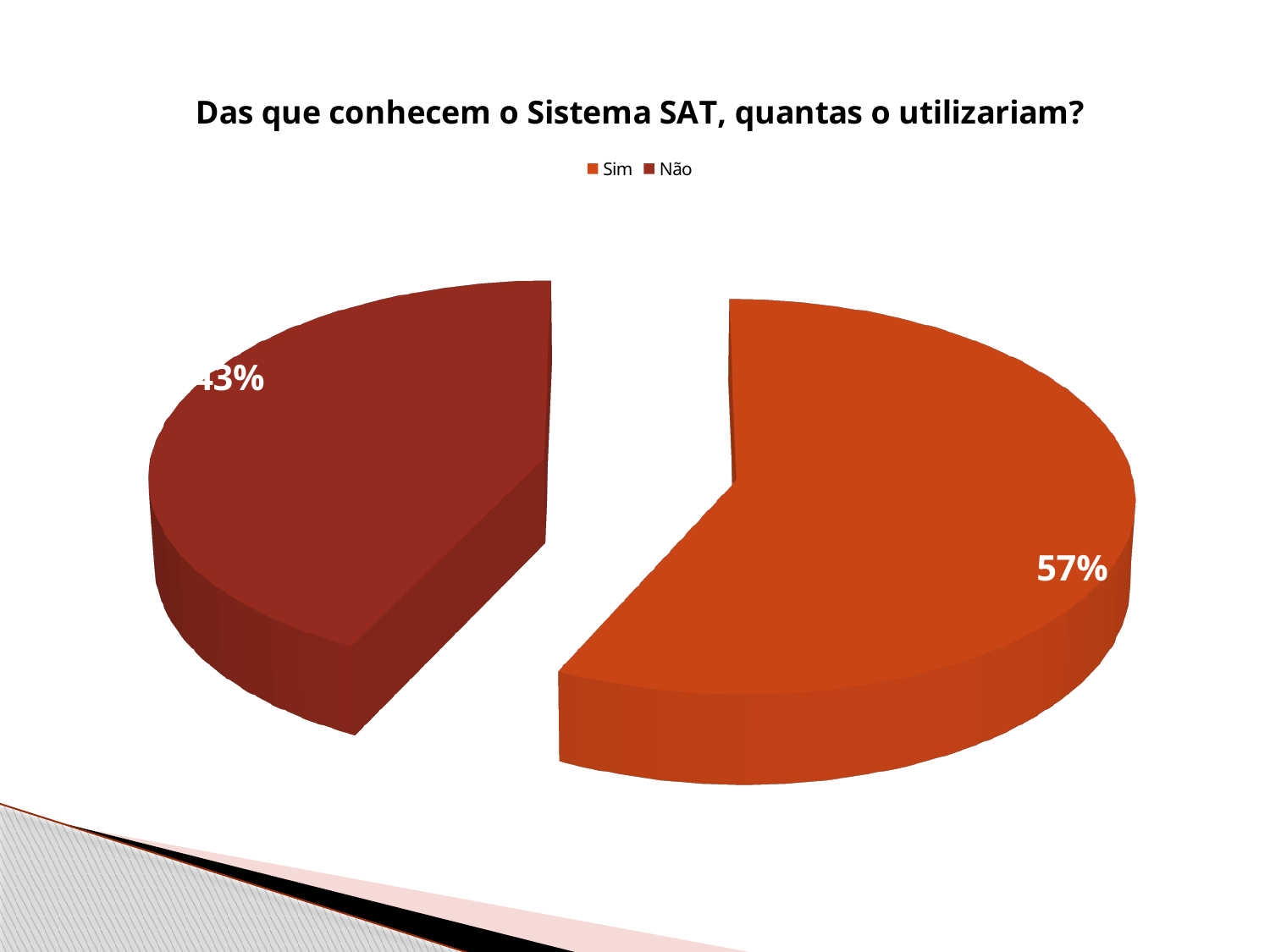
How many slices does the pie chart have? 2 Which slice is the largest? Sim What is the difference in percentage points between the Sim and Não slices? 14 percentage points What kind of chart is shown on the slide? Pie chart What are the two categories listed in the legend? Sim and Não What share of the pie does the Sim slice represent? 57% How many series does the legend list? 2 Which is larger, the Sim slice or the Não slice? Sim What is the title of the chart? Das que conhecem o Sistema SAT, quantas o utilizariam? What percentage of the pie is labelled for Não? 43% Which slice is the smallest? Não What percentage of the pie is labelled for Sim? 57%